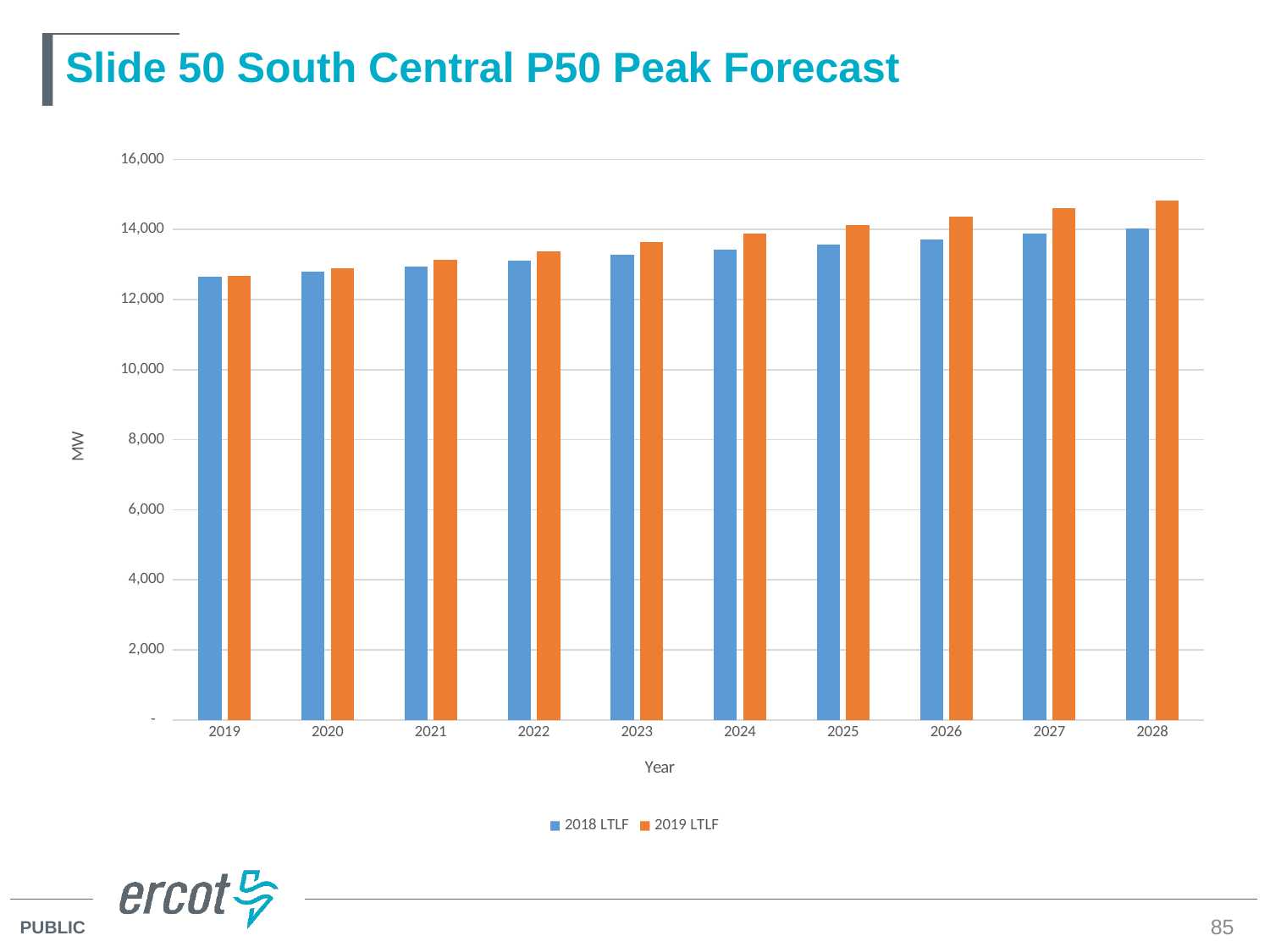
Which year has the lowest 2018 LTLF value? 2019 How many series does the legend list? 2 For 2027, which is larger: the 2018 LTLF value or the 2019 LTLF value? 2019 LTLF What is the label of the y axis? MW Is the 2018 LTLF value for 2019 greater or less than 12,000? greater Is the 2018 LTLF value for 2024 greater or less than 14,000? less Is the 2019 LTLF value for 2026 greater or less than 14,000? greater What kind of chart is shown on the slide? bar chart How many years are shown on the x axis? 10 Which year has the highest 2019 LTLF value? 2028 Do the 2019 LTLF values rise or fall from 2019 to 2028? rise